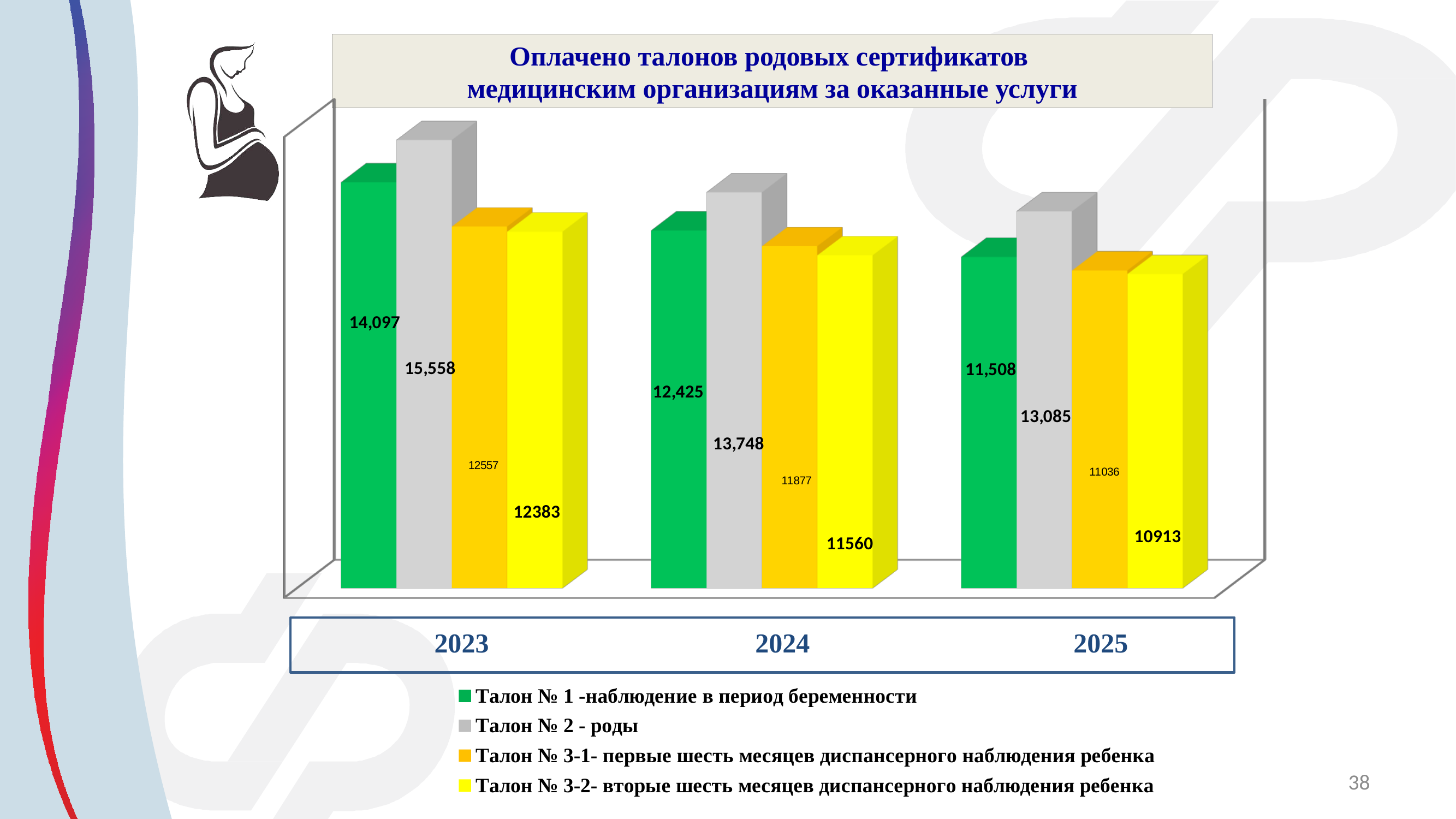
What is the difference between Талон № 2 and Талон № 1 in 2023? 1,461 What is the value for Талон № 3-2 in 2023? 12383 Which is larger in 2025: Талон № 3-1 or Талон № 3-2? Талон № 3-1 How many years (categories) are shown on the x axis? 3 What is the value for Талон № 3-1 in 2025? 11036 What is the value for Талон № 2 (роды) in 2024? 13,748 How many series does the legend list? 4 What is the difference between the Талон № 3-2 values for 2024 and 2025? 647 In which year is the value for Талон № 2 (роды) the highest? 2023 What is the value for Талон № 1 (наблюдение в период беременности) in 2023? 14,097 In which year is the value for Талон № 1 the lowest? 2025 Do the values for Талон № 2 (роды) rise or fall from 2023 to 2025? fall